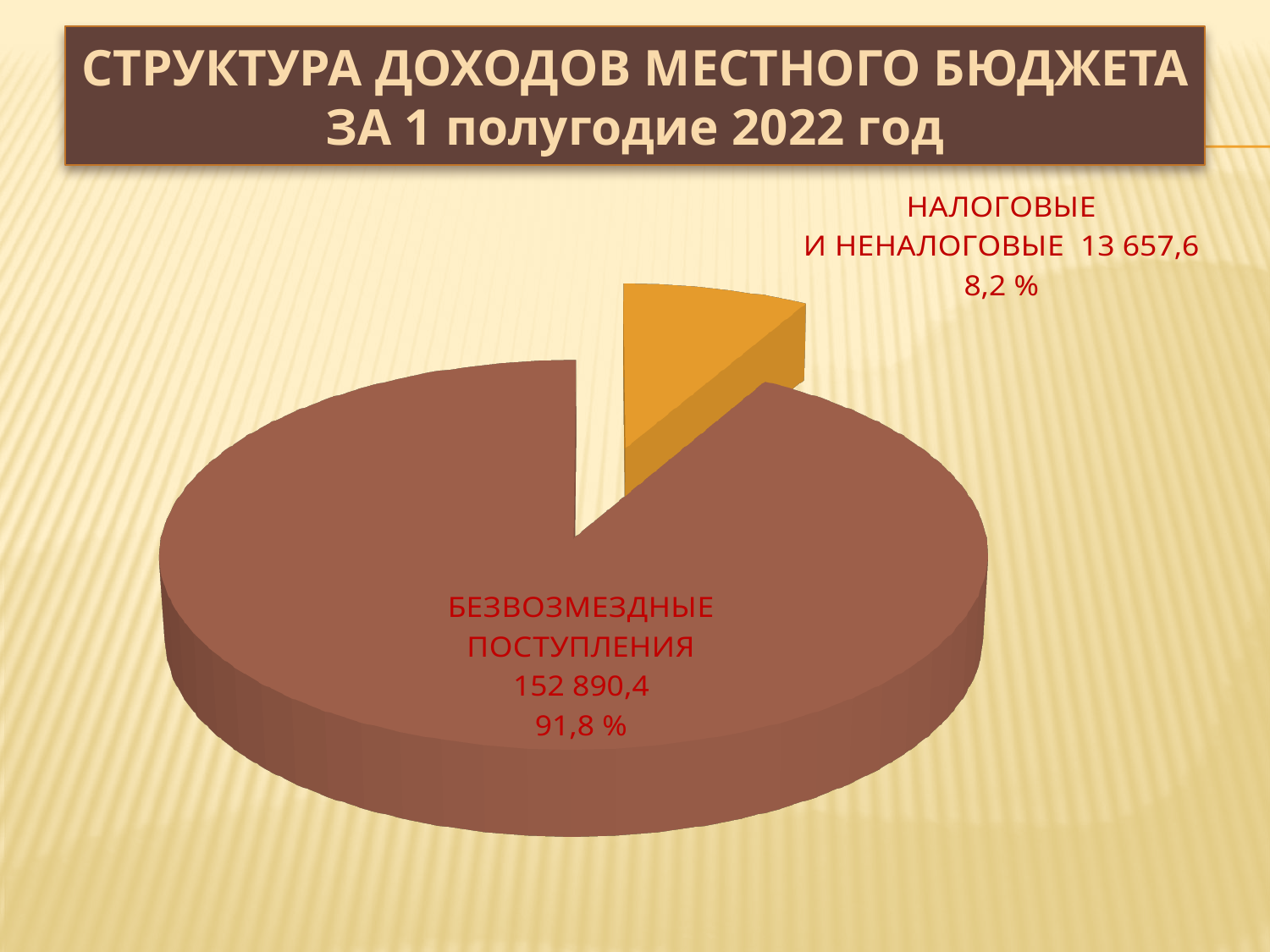
Which category has the smallest slice of the pie? НАЛОГОВЫЕ И НЕНАЛОГОВЫЕ What kind of chart is shown on the slide? pie chart What is the value shown for НАЛОГОВЫЕ И НЕНАЛОГОВЫЕ? 13 657,6 What colour is the slice for НАЛОГОВЫЕ И НЕНАЛОГОВЫЕ? orange How many slices does the pie chart have? 2 What share of the pie does БЕЗВОЗМЕЗДНЫЕ ПОСТУПЛЕНИЯ represent? 91,8 % What is the title of the slide containing the chart? СТРУКТУРА ДОХОДОВ МЕСТНОГО БЮДЖЕТА ЗА 1 полугодие 2022 год What share of the pie does НАЛОГОВЫЕ И НЕНАЛОГОВЫЕ represent? 8,2 % Which is larger, БЕЗВОЗМЕЗДНЫЕ ПОСТУПЛЕНИЯ or НАЛОГОВЫЕ И НЕНАЛОГОВЫЕ? БЕЗВОЗМЕЗДНЫЕ ПОСТУПЛЕНИЯ What is the value shown for БЕЗВОЗМЕЗДНЫЕ ПОСТУПЛЕНИЯ? 152 890,4 Which category has the largest slice of the pie? БЕЗВОЗМЕЗДНЫЕ ПОСТУПЛЕНИЯ What is the difference between the values for БЕЗВОЗМЕЗДНЫЕ ПОСТУПЛЕНИЯ and НАЛОГОВЫЕ И НЕНАЛОГОВЫЕ? 139 232,8